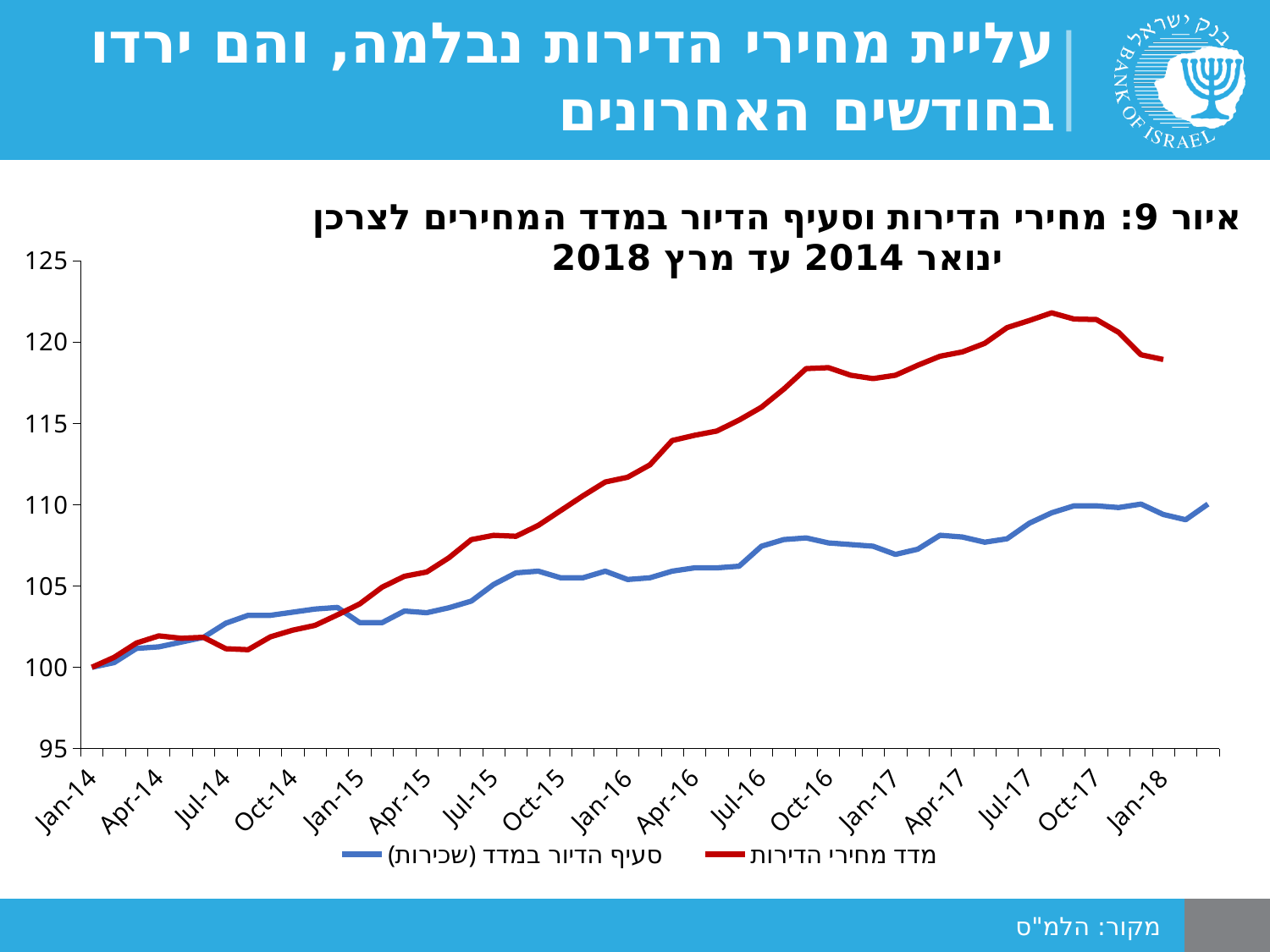
Does the מדד מחירי הדירות series generally rise or fall from Jan-14 to Jul-17? rise Is the value of סעיף הדיור במדד (שכירות) at Jan-18 greater or less than 110? less How many series does the legend list? 2 Is the value of מדד מחירי הדירות at Oct-17 greater or less than 120? greater Is the value of מדד מחירי הדירות at Jan-16 greater or less than 110? greater What is the value of both series at Jan-14? 100 What kind of chart is shown on the slide? line chart What colour is the line for מדד מחירי הדירות? red Does the מדד מחירי הדירות series rise or fall between Oct-17 and the end of the chart? fall Which series has the higher value at Oct-14, מדד מחירי הדירות or סעיף הדיור במדד (שכירות)? סעיף הדיור במדד (שכירות) Which series has the higher value at Jan-18, מדד מחירי הדירות or סעיף הדיור במדד (שכירות)? מדד מחירי הדירות